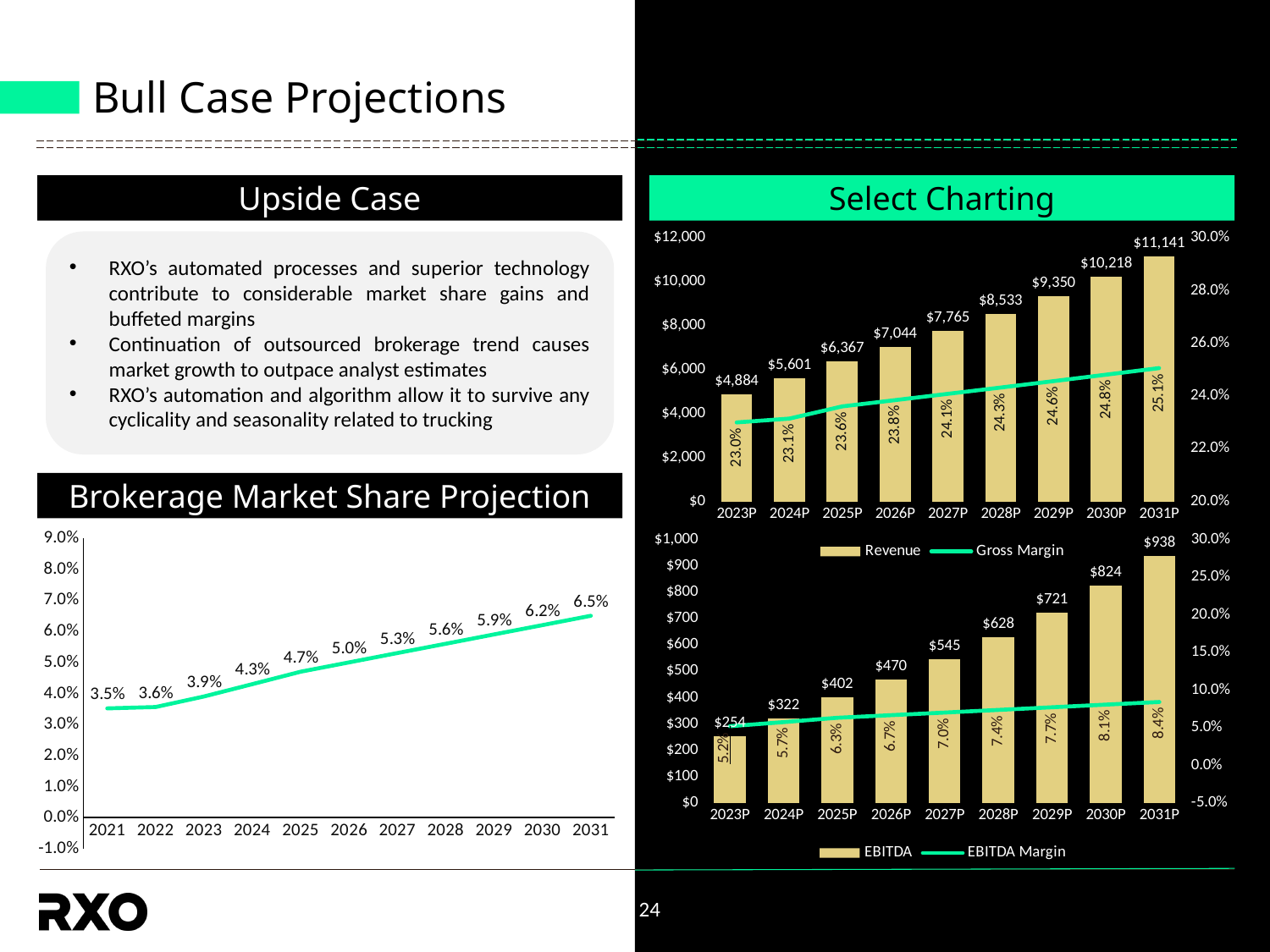
In the Brokerage Market Share Projection chart, what is the value for 2021? 3.5% In the Brokerage Market Share Projection chart, what type of chart is shown? line chart In the Revenue and Gross Margin chart (top right), what is the revenue for 2027P? $7,765 In the EBITDA and EBITDA Margin chart (bottom right), which year has the lowest EBITDA? 2023P In the Revenue and Gross Margin chart (top right), what is the difference in revenue between 2031P and 2023P? $6,257 In the Revenue and Gross Margin chart (top right), what is the gross margin for 2031P? 25.1% In the Brokerage Market Share Projection chart, how many years are plotted? 11 In the Brokerage Market Share Projection chart, what is the value for 2031? 6.5% In the Revenue and Gross Margin chart (top right), which series does the legend list? Revenue and Gross Margin In the EBITDA and EBITDA Margin chart (bottom right), what is the EBITDA for 2029P? $721 In the Brokerage Market Share Projection chart, do the values rise or fall from 2021 to 2031? rise In the EBITDA and EBITDA Margin chart (bottom right), what is the EBITDA margin for 2026P? 6.7%